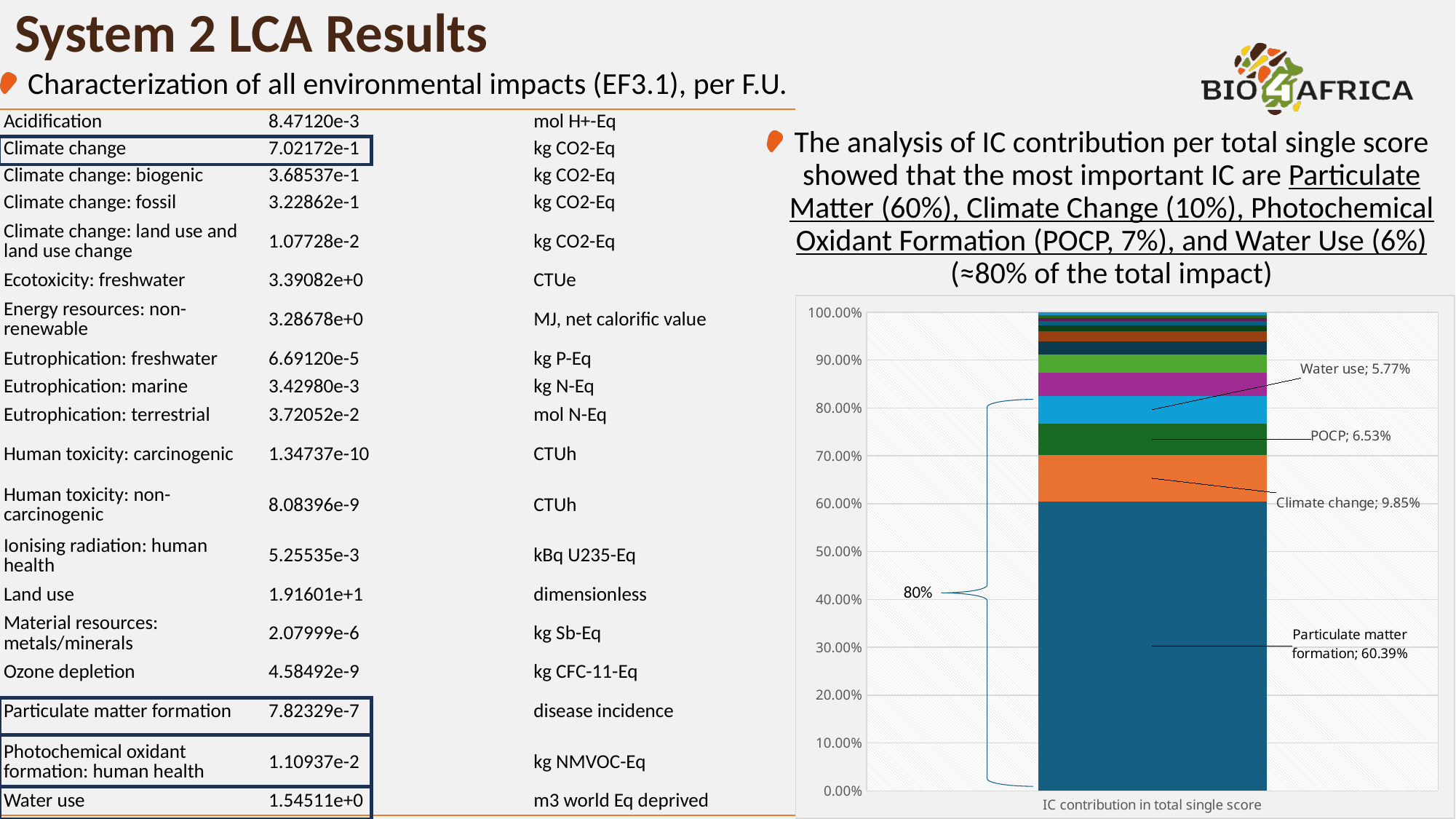
Which contributes more to the total single score, POCP or Water use? POCP Is the contribution of Particulate matter formation greater or less than 50%? greater What is the difference between the Particulate matter formation and Climate change contributions? 50.54% What share of the total single score does Particulate matter formation contribute? 60.39% What is the labelled value for Climate change in the stacked bar? 9.85% What is the label on the x axis of the chart? IC contribution in total single score What is the labelled value for POCP in the stacked bar? 6.53% Which labelled impact category has the largest contribution to the total single score? Particulate matter formation What is the combined contribution of the four labelled segments (Particulate matter formation, Climate change, POCP and Water use)? 82.54% What kind of chart is shown on the slide? Stacked bar chart What is the labelled value for Water use in the stacked bar? 5.77% Of the four labelled segments, which has the smallest contribution? Water use